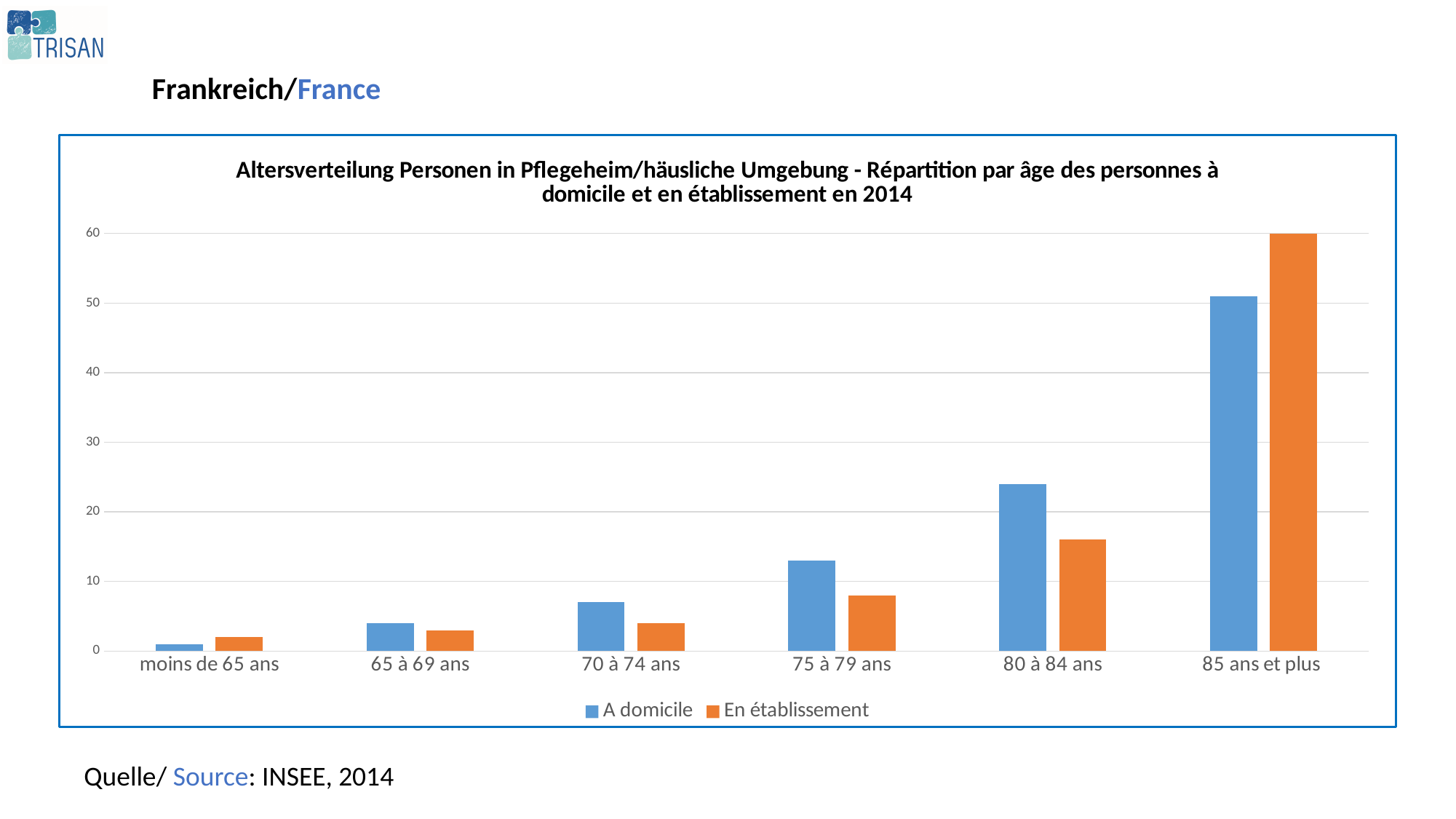
In the 80 à 84 ans category, which series has the larger value, A domicile or En établissement? A domicile Is the value for En établissement in the 75 à 79 ans category greater or less than 10? less How many age categories are shown on the x axis? 6 What kind of chart is shown on the slide? bar chart In the 85 ans et plus category, which series has the larger value, A domicile or En établissement? En établissement Which colour represents the A domicile series in the legend? blue Is the value for A domicile in the 80 à 84 ans category greater or less than 20? greater Do the values for En établissement rise or fall as the age categories move from left to right? rise Which age category has the lowest value for A domicile? moins de 65 ans How many series does the legend list? 2 Which age category has the highest value for En établissement? 85 ans et plus